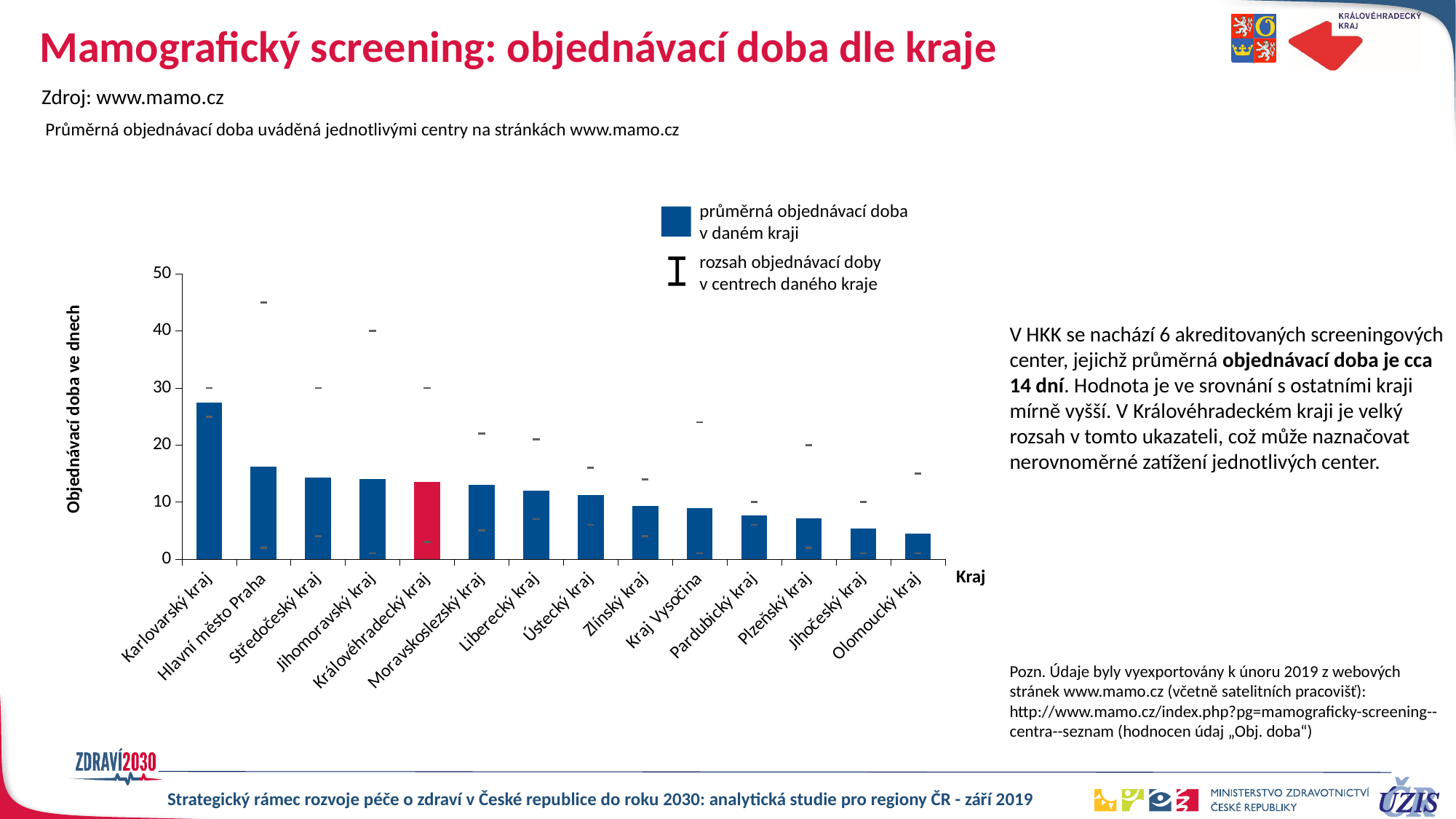
Which region has the highest average ordering time (tallest bar)? Karlovarský kraj Which region's bar is highlighted in red instead of blue? Královéhradecký kraj Is the value for Karlovarský kraj greater or less than 30? less Do the bar values rise or fall moving from left to right along the x axis? fall Is the value for Karlovarský kraj greater or less than 20? greater Which region has the lowest average ordering time (shortest bar)? Olomoucký kraj Is the value for Hlavní město Praha greater or less than 10? greater How many regions (kraje) are plotted on the x axis of the chart? 14 What kind of chart is shown on the slide? bar chart How many entries does the chart legend list? 2 Which is larger, the bar for Karlovarský kraj or the bar for Hlavní město Praha? Karlovarský kraj